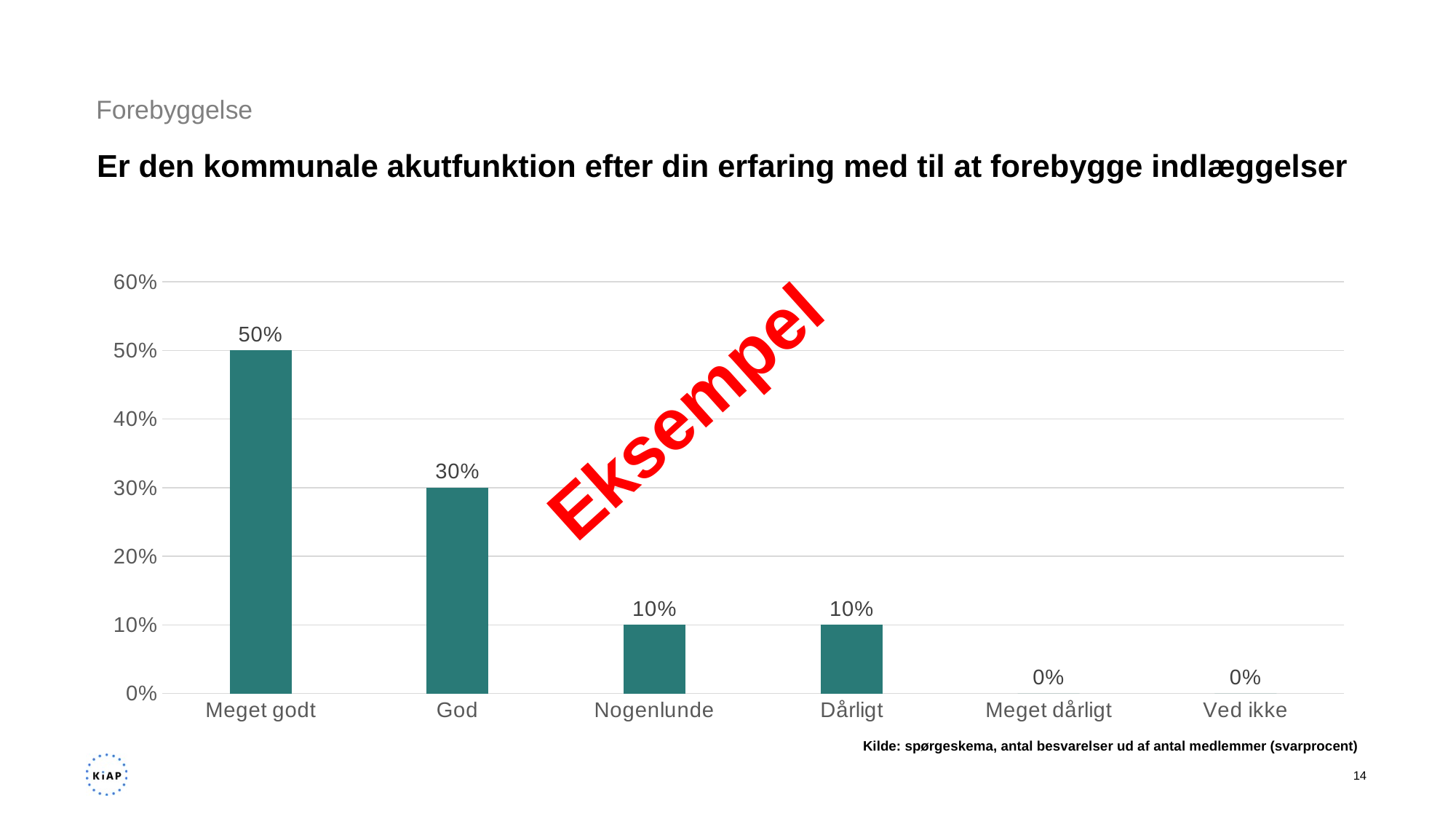
What is the difference between the values for "Meget godt" and "God"? 20% Do the values rise or fall from "Meget godt" to "Dårligt" along the x axis? Fall What is the value for "Nogenlunde"? 10% What is the value for "Meget dårligt"? 0% Is the value for "Meget godt" greater or less than 40%? greater What is the value for "God"? 30% Which category has the highest value? Meget godt How many categories are shown on the x axis? 6 What is the value for "Meget godt"? 50% What is the difference between the values for "God" and "Dårligt"? 20% Which is larger, the value for "God" or the value for "Nogenlunde"? God What kind of chart is shown on the slide? Bar chart